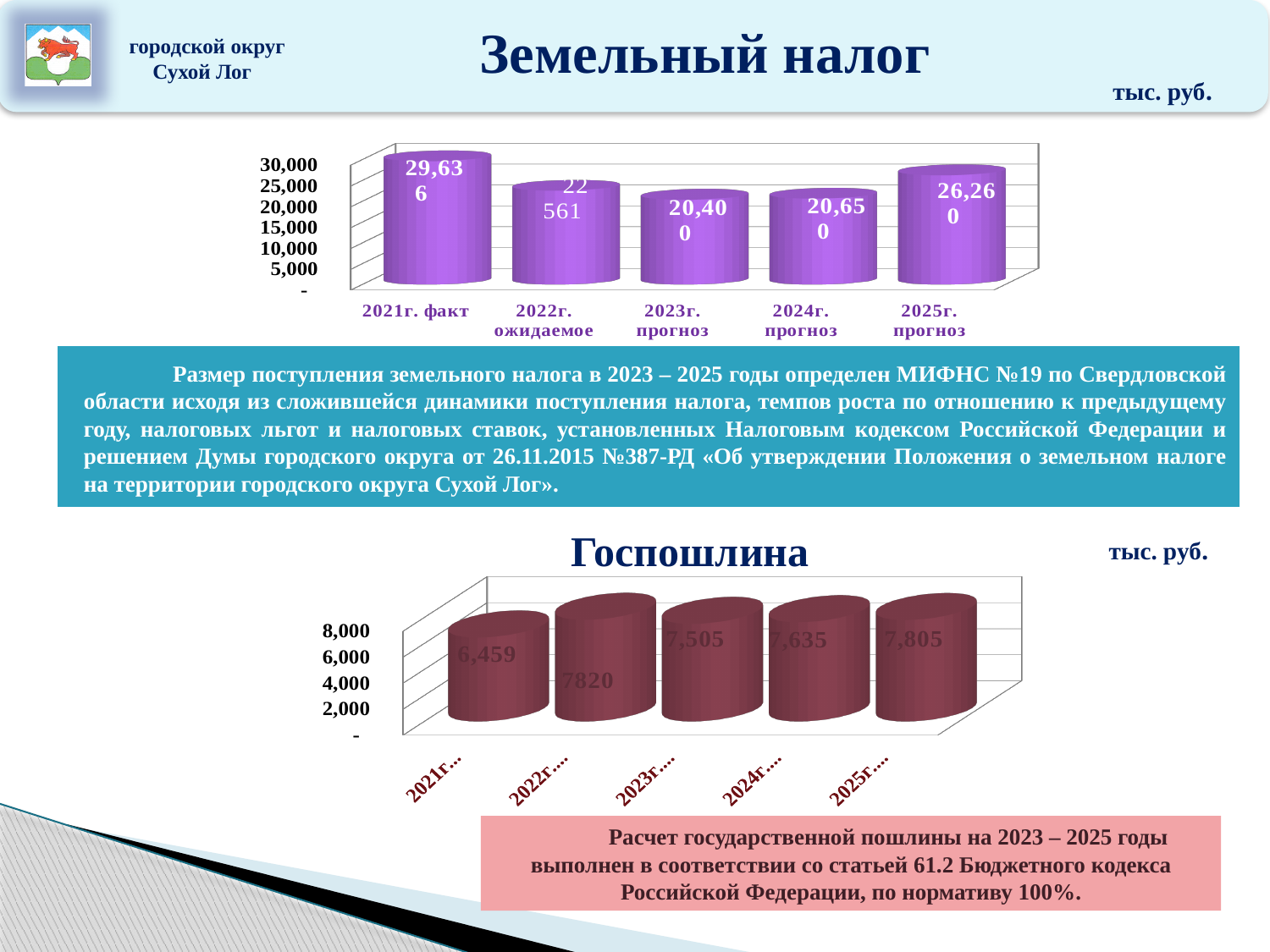
On the Земельный налог chart, which category has the highest value? 2021г. факт On the Госпошлина chart, which is larger, the value for 2022г. or the value for 2023г.? 2022г. On the Госпошлина chart, what is the value for 2021г.? 6,459 On the Госпошлина chart, what is the value for 2025г.? 7,805 On the Земельный налог chart, what is the value for 2021г. факт? 29,636 On the Земельный налог chart, what is the difference between the values for 2025г. прогноз and 2024г. прогноз? 5,610 On the Госпошлина chart, which category has the lowest value? 2021г. On the Земельный налог chart, how many categories are shown? 5 On the Земельный налог chart, what is the value for 2025г. прогноз? 26,260 On the Земельный налог chart, what is the value for 2023г. прогноз? 20,400 On the Земельный налог chart, which category has the lowest value? 2023г. прогноз What kind of chart is the Госпошлина chart? Bar chart